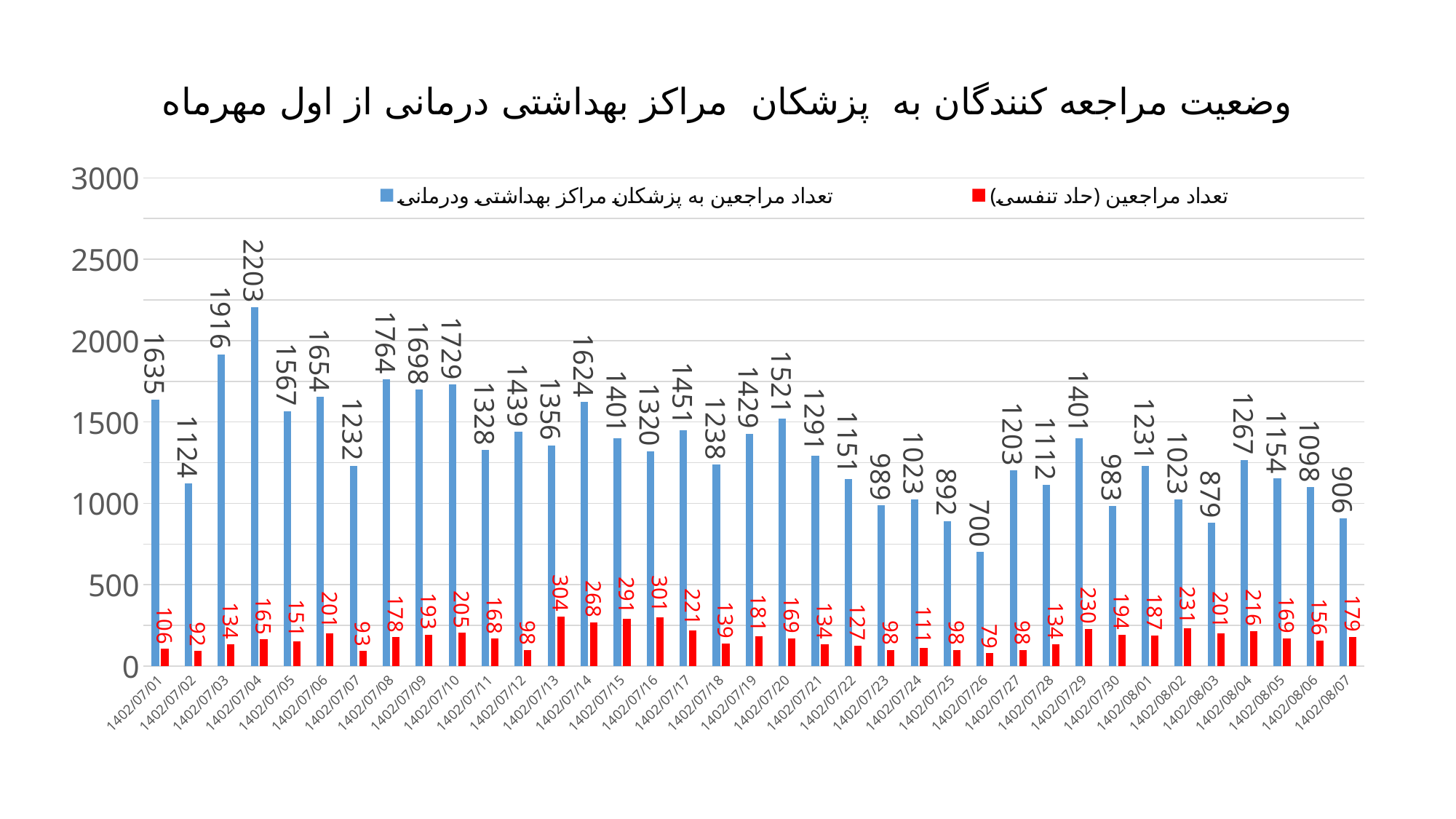
Which is larger: the blue series value on 1402/07/08 or on 1402/07/10? 1402/07/08 What is the value of the blue series (تعداد مراجعین به پزشکان مراکز بهداشتی ودرمانی) on 1402/07/04? 2203 What is the value of the red series (تعداد مراجعین (حاد تنفسی)) on 1402/07/13? 304 How many dates (categories) are plotted along the x axis? 37 On which date is the red series (acute respiratory visitors) lowest? 1402/07/26 What is the difference between the blue series values on 1402/07/04 and 1402/07/03? 287 What colour are the bars for the series تعداد مراجعین (حاد تنفسی)? red Is the blue series value on 1402/08/07 greater or less than 1000? less On which date is the blue series (total visitors to physicians) lowest? 1402/07/26 How many series does the legend list? 2 What type of chart is shown on the slide? bar chart On which date is the blue series (total visitors to physicians) highest? 1402/07/04